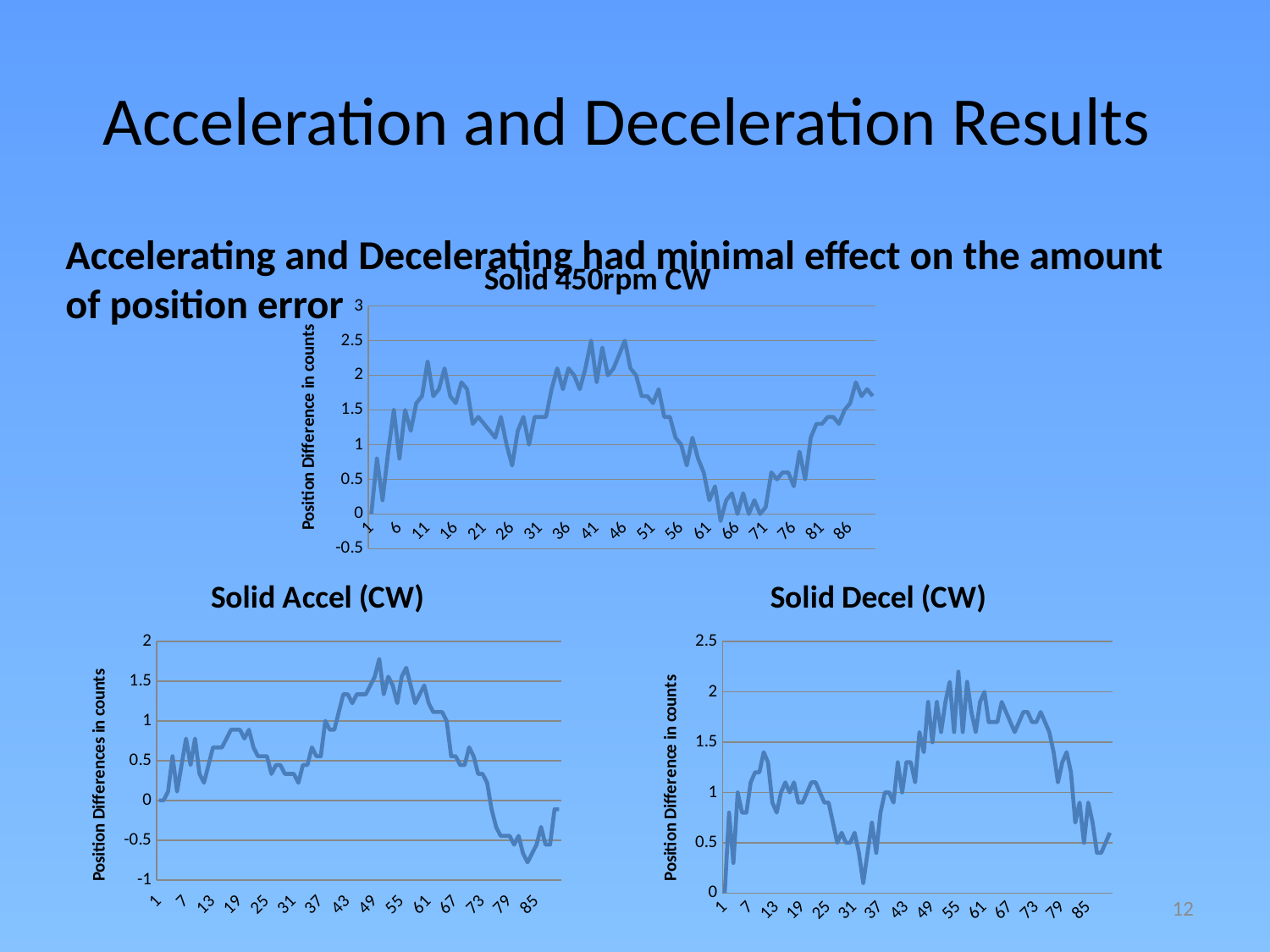
What is the y-axis label of the 'Solid Accel (CW)' chart? Position Differences in counts In the 'Solid Accel (CW)' chart, is the value at x = 79 greater or less than 0? less In the 'Solid 450rpm CW' chart, is the value at x = 41 greater or less than 1? greater In the 'Solid Accel (CW)' chart, is the value at x = 49 greater or less than 1? greater How many charts are shown on the slide? 3 What kind of chart is the 'Solid Accel (CW)' chart? line chart In the 'Solid Accel (CW)' chart, is the value at x = 49 larger or smaller than the value at x = 79? larger What is the title of the chart at the bottom right of the slide? Solid Decel (CW) What kind of chart is the 'Solid 450rpm CW' chart? line chart